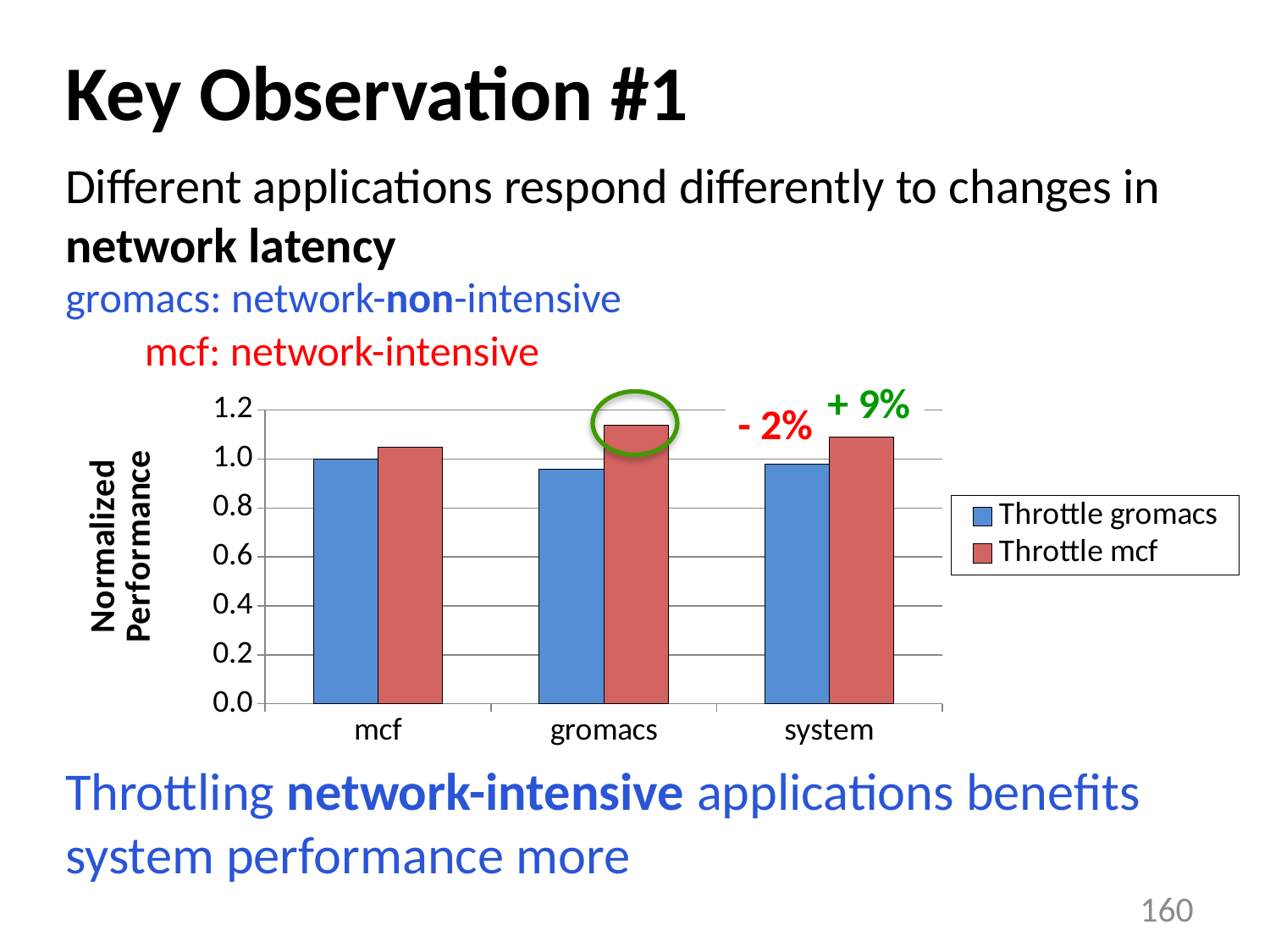
Is the Throttle mcf value for system greater or less than 1.2? less How many categories are shown on the x axis of the chart? 3 Is the Throttle mcf value for gromacs greater or less than 1.0? greater What is the label of the chart's y axis? Normalized Performance What are the two series named in the chart's legend? Throttle gromacs and Throttle mcf What kind of chart is shown on the slide? bar chart Is the Throttle gromacs value for mcf greater or less than 0.8? greater For the system category, which series has the larger value, Throttle gromacs or Throttle mcf? Throttle mcf For the gromacs category, which series has the larger value, Throttle gromacs or Throttle mcf? Throttle mcf How many series does the chart's legend list? 2 Which category has the highest value for the Throttle mcf series? gromacs